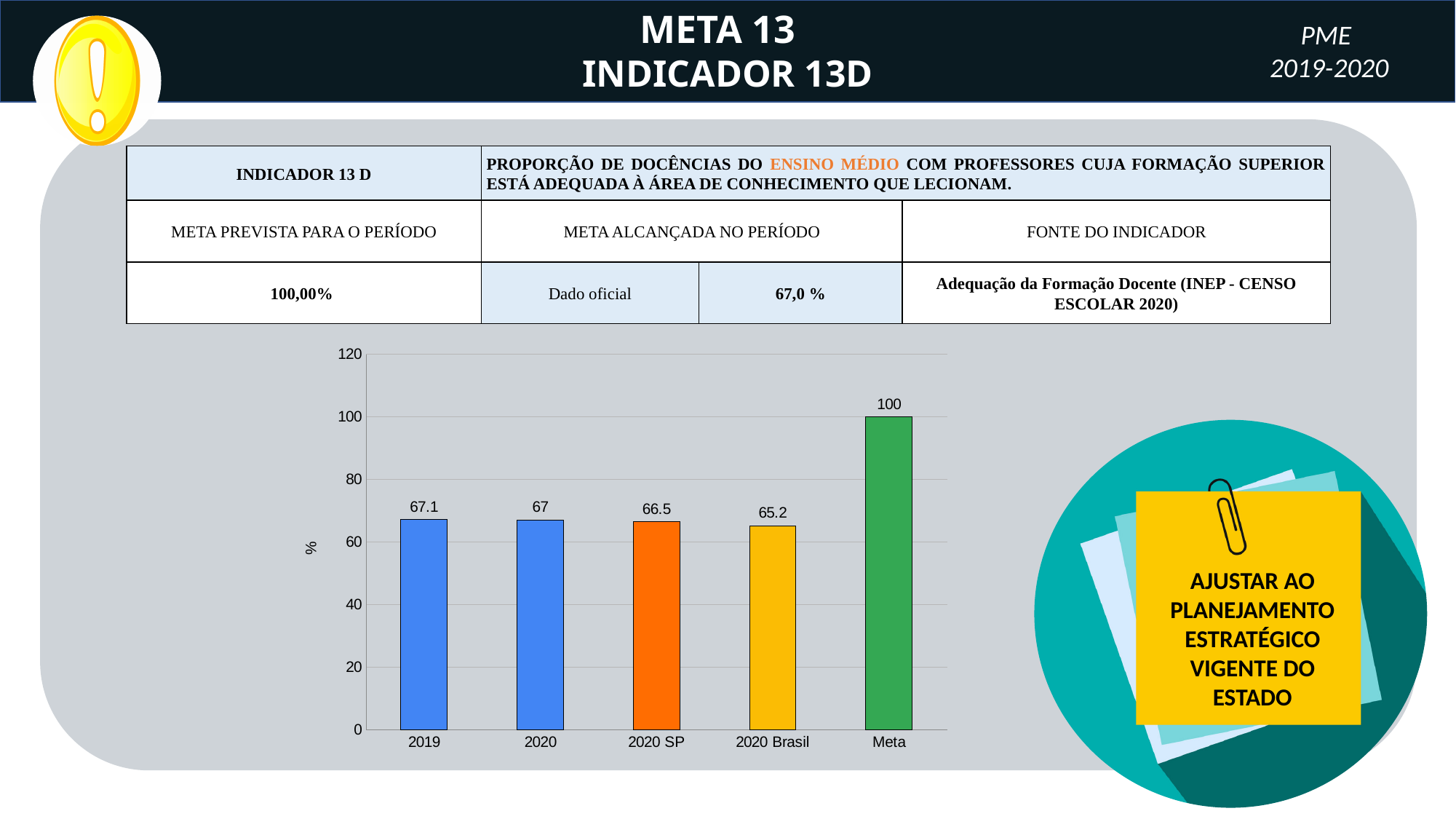
What is the label on the vertical axis of the chart? % Which is larger, the value for 2020 SP or the value for 2020 Brasil? 2020 SP Which category has the highest value in the bar chart? Meta What is the difference between the 2019 value and the 2020 Brasil value? 1.9 What is the value for 2020 Brasil in the bar chart? 65.2 What type of chart is shown on the slide? bar chart Is the value for 2020 greater or less than 80? less What is the value for 2020 SP in the bar chart? 66.5 What is the value for 2019 in the bar chart? 67.1 What is the difference between the Meta value and the 2020 value? 33 How many bars are shown in the chart? 5 Which category has the lowest value in the bar chart? 2020 Brasil